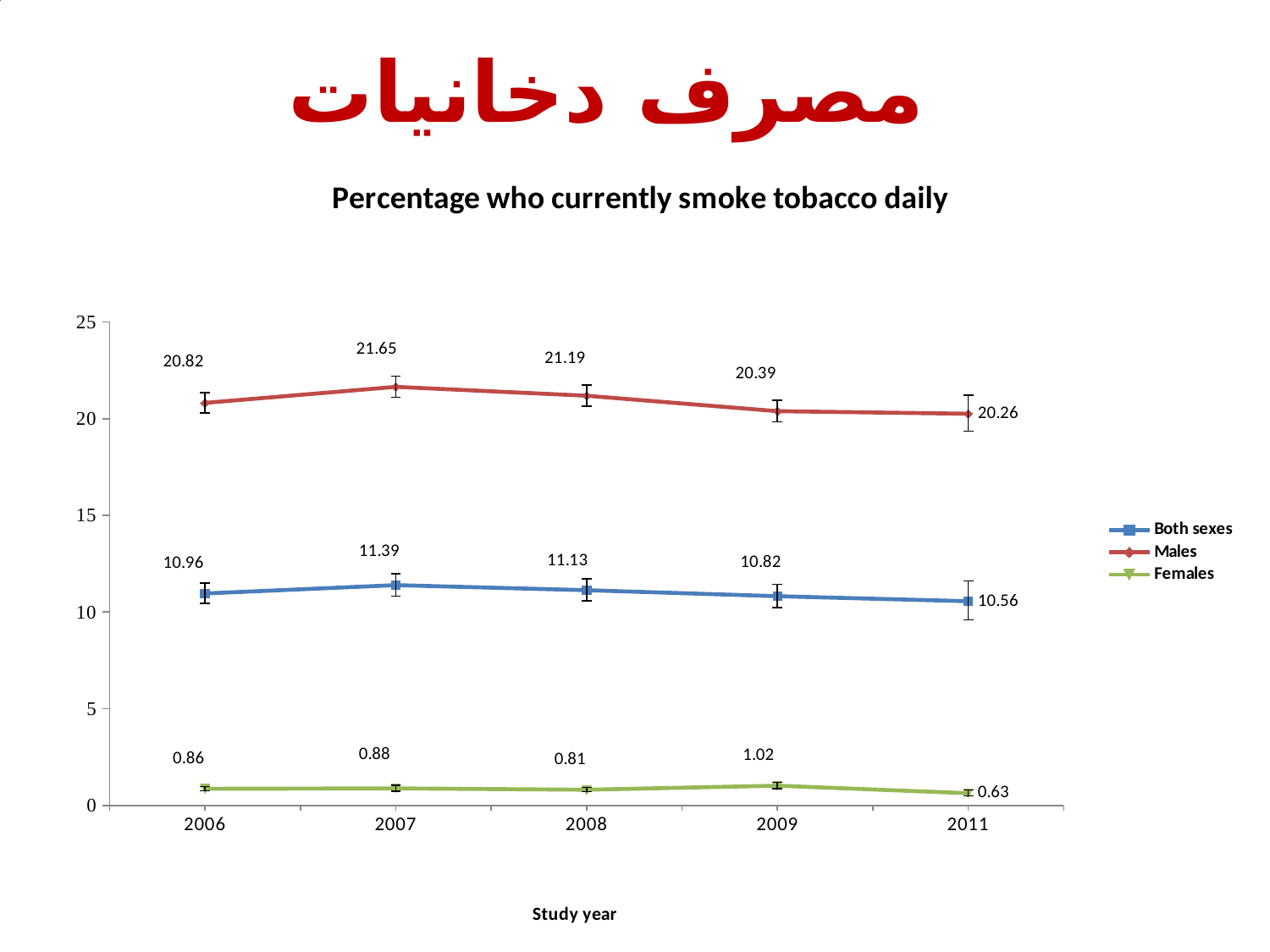
Is the value for Males in 2006 greater or less than 20? greater In which year is the Females value lowest? 2011 In which year is the Males value highest? 2007 How many study years are plotted on the x axis? 5 What is the value for Males in 2007? 21.65 What is the value for Females in 2011? 0.63 What is the value for Both sexes in 2009? 10.82 What kind of chart is shown? line chart How many series does the legend list? 3 What is the title of the chart? Percentage who currently smoke tobacco daily What is the difference between the Males values in 2007 and 2011? 1.39 Which is larger, the Females value in 2009 or in 2008? 2009